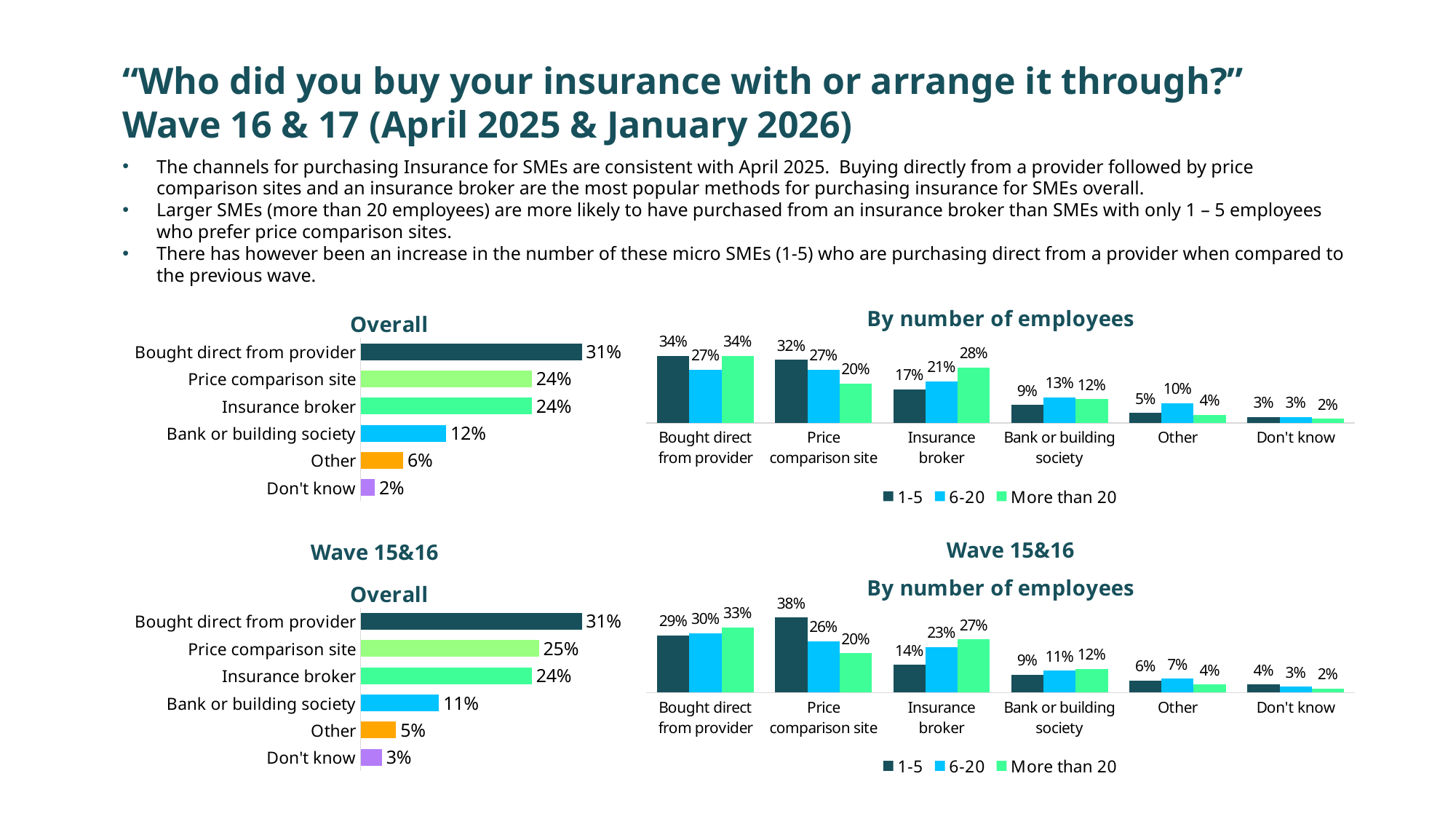
In the bottom-left 'Wave 15&16 Overall' chart, how many categories are shown? 6 In the top-left 'Overall' chart, which category has the lowest value? Don't know In the top-right 'By number of employees' chart, what is the value for Insurance broker for the More than 20 series? 28% What type of chart is the top-left 'Overall' chart? Bar chart In the bottom-left 'Wave 15&16 Overall' chart, what is the value for Price comparison site? 25% In the top-right 'By number of employees' chart, how many series does the legend list? 3 In the bottom-right 'Wave 15&16 By number of employees' chart, what is the difference between the 6-20 and 1-5 values for Insurance broker? 9% In the top-right 'By number of employees' chart, which is larger for Price comparison site: the 1-5 series or the More than 20 series? 1-5 In the top-left 'Overall' chart, what is the difference between Bought direct from provider and Bank or building society? 19% In the bottom-right 'Wave 15&16 By number of employees' chart, what is the value for Bought direct from provider for the 1-5 series? 29% In the top-left 'Overall' chart, what is the value for Bought direct from provider? 31% In the bottom-right 'Wave 15&16 By number of employees' chart, which category has the highest value for the 1-5 series? Price comparison site